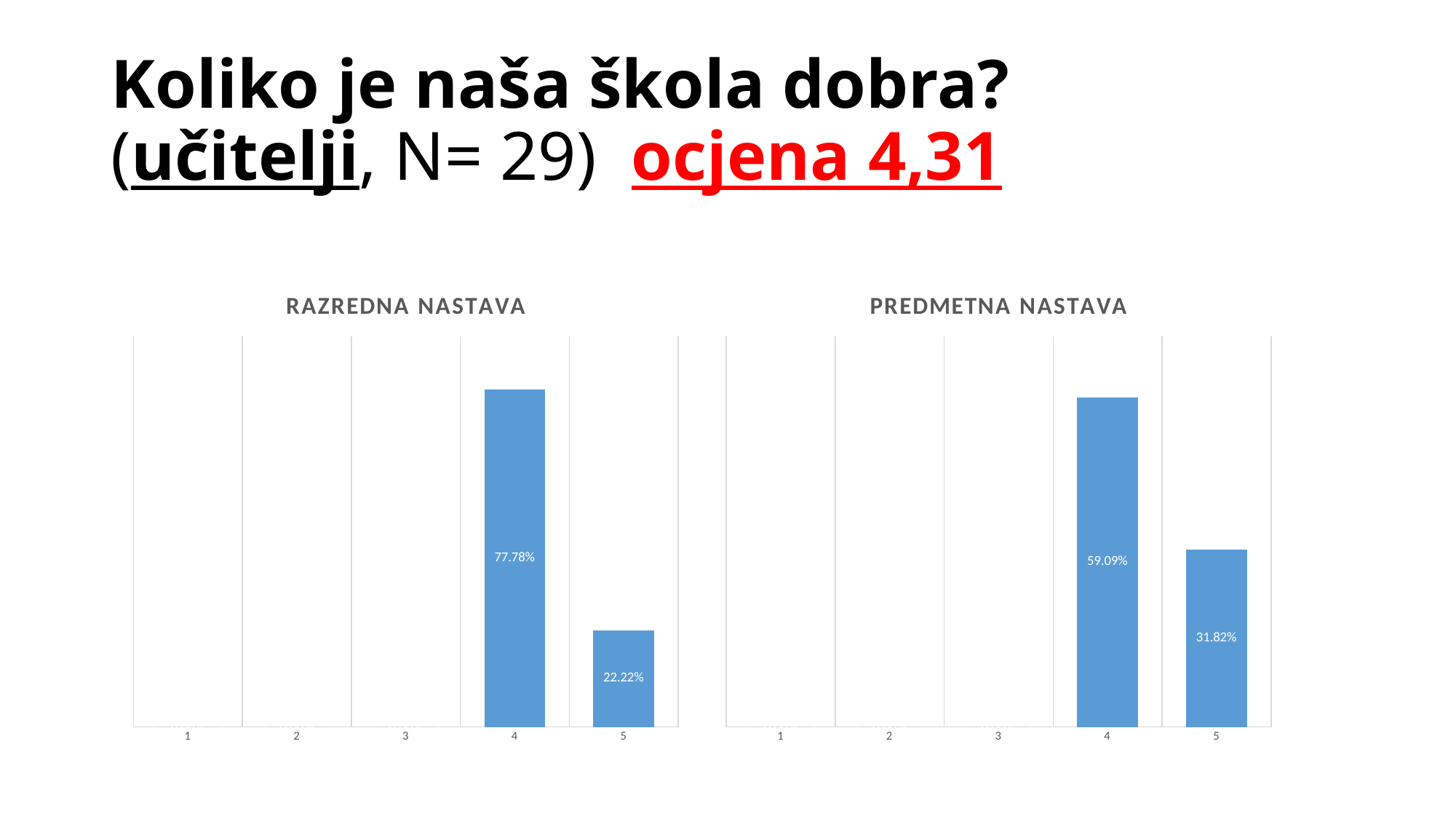
How many categories are shown on the x axis of the RAZREDNA NASTAVA chart? 5 What is the title of the chart on the left side of the slide? RAZREDNA NASTAVA In the RAZREDNA NASTAVA chart, which category has the highest value? 4 In the RAZREDNA NASTAVA chart, what is the difference between the values for category 4 and category 5? 55.56% In the PREDMETNA NASTAVA chart, what is the value for category 4? 59.09% Which chart has the larger value for category 5, RAZREDNA NASTAVA or PREDMETNA NASTAVA? PREDMETNA NASTAVA What kind of chart is the PREDMETNA NASTAVA chart? Bar chart In the RAZREDNA NASTAVA chart, what is the value for category 4? 77.78% In the RAZREDNA NASTAVA chart, what is the value for category 5? 22.22% In the PREDMETNA NASTAVA chart, which category has the highest value? 4 In the PREDMETNA NASTAVA chart, what is the difference between the values for category 4 and category 5? 27.27% In the PREDMETNA NASTAVA chart, what is the value for category 5? 31.82%